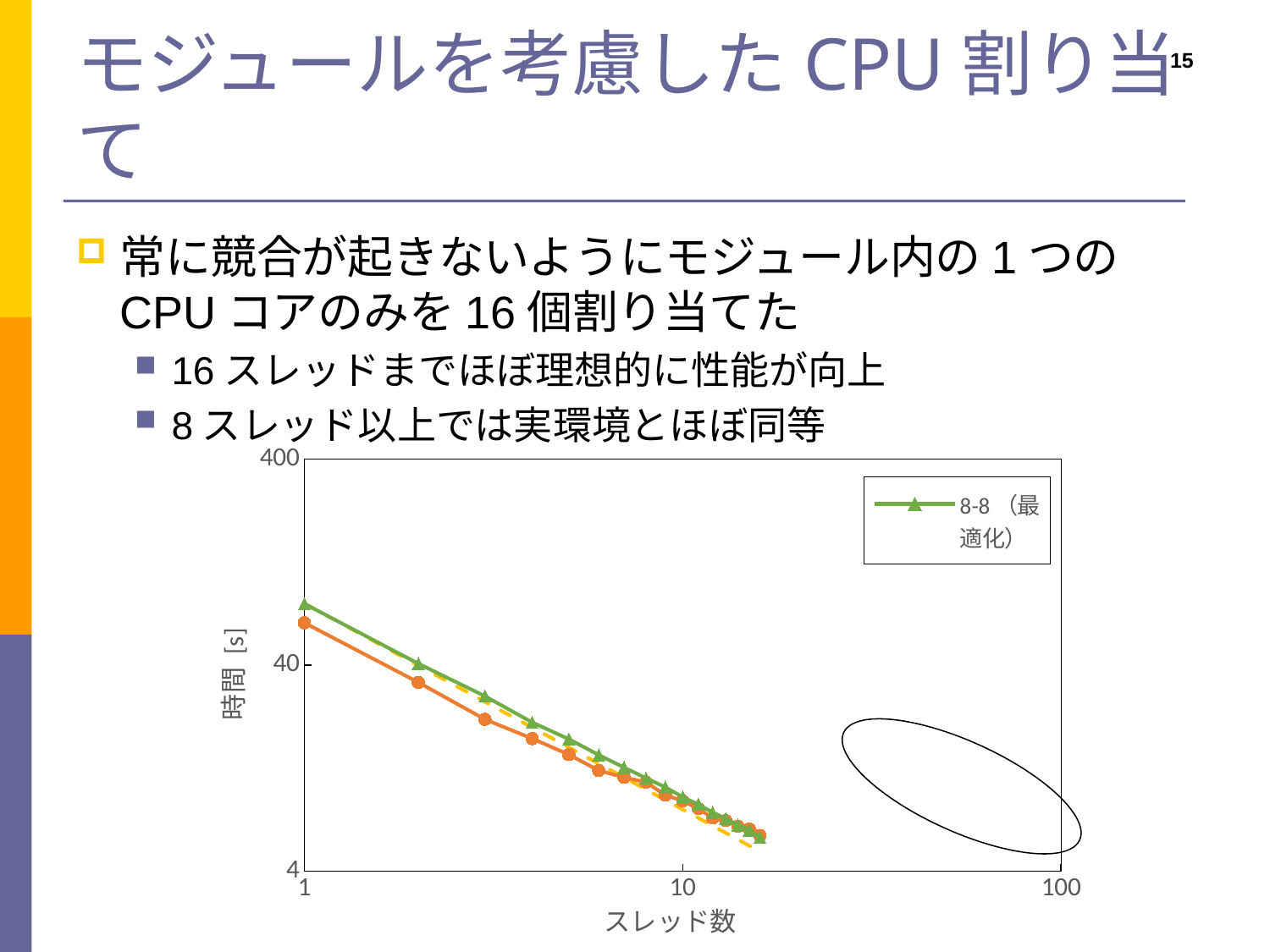
Is the value of the 8-8 (最適化) series at its rightmost point (around 16 threads) greater or less than 40? less What is the series name shown in the chart's legend? 8-8 （最適化） How many series does the chart's legend list? 1 Is the value of the 8-8 (最適化) series at 10 threads greater or less than 40? less Is the value of the 8-8 (最適化) series at its rightmost point (around 16 threads) greater or less than 4? greater What kind of chart is shown on the slide? line chart As the number of threads (スレッド数) increases, does the time (時間) for the 8-8 (最適化) series rise or fall? fall At which thread count does the 8-8 (最適化) series reach its highest time value? 1 What is the label of the chart's x axis? スレッド数